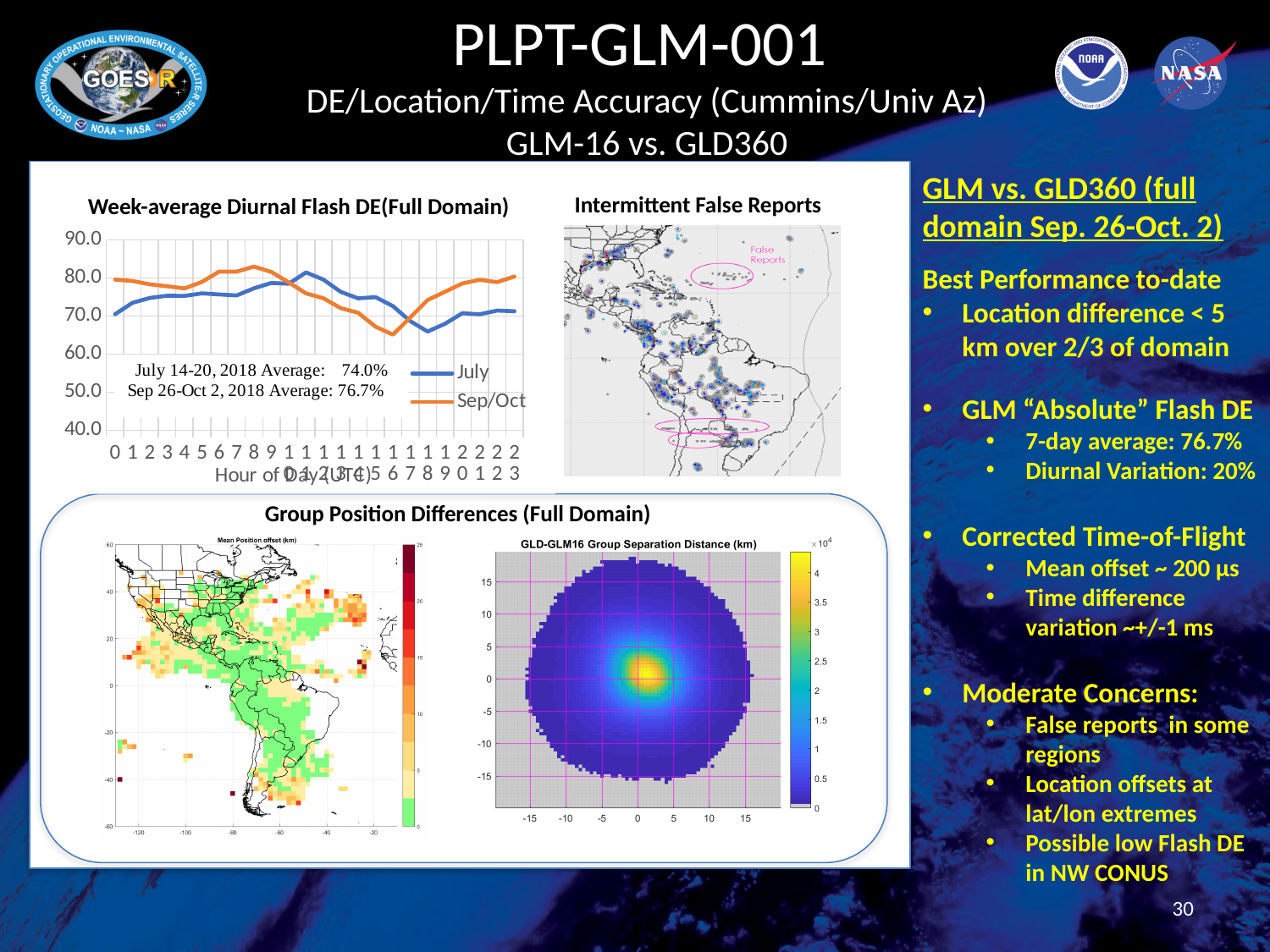
In the 'Week-average Diurnal Flash DE(Full Domain)' chart, which series is higher at hour 0, July or Sep/Oct? Sep/Oct What is the x-axis label of the 'Week-average Diurnal Flash DE(Full Domain)' chart? Hour of Day (UTC) In the 'Week-average Diurnal Flash DE(Full Domain)' chart, which period has the higher week average, July 14-20 or Sep 26-Oct 2? Sep 26-Oct 2 What are the two series named in the legend of the 'Week-average Diurnal Flash DE(Full Domain)' chart? July and Sep/Oct In the 'Week-average Diurnal Flash DE(Full Domain)' chart, what is the July 14-20, 2018 average? 74.0% In the 'Week-average Diurnal Flash DE(Full Domain)' chart, is the Sep/Oct value at hour 8 greater or less than 80.0? greater What kind of chart is the 'Week-average Diurnal Flash DE(Full Domain)' chart? line chart In the 'Week-average Diurnal Flash DE(Full Domain)' chart, by how much does the Sep 26-Oct 2 average exceed the July 14-20 average? 2.7% In the 'Week-average Diurnal Flash DE(Full Domain)' chart, is the July value at hour 0 greater or less than 80.0? less In the 'Week-average Diurnal Flash DE(Full Domain)' chart, what is the Sep 26-Oct 2, 2018 average? 76.7% How many series does the legend of the 'Week-average Diurnal Flash DE(Full Domain)' chart list? 2 How many hours of the day are plotted along the x axis of the 'Week-average Diurnal Flash DE(Full Domain)' chart? 24